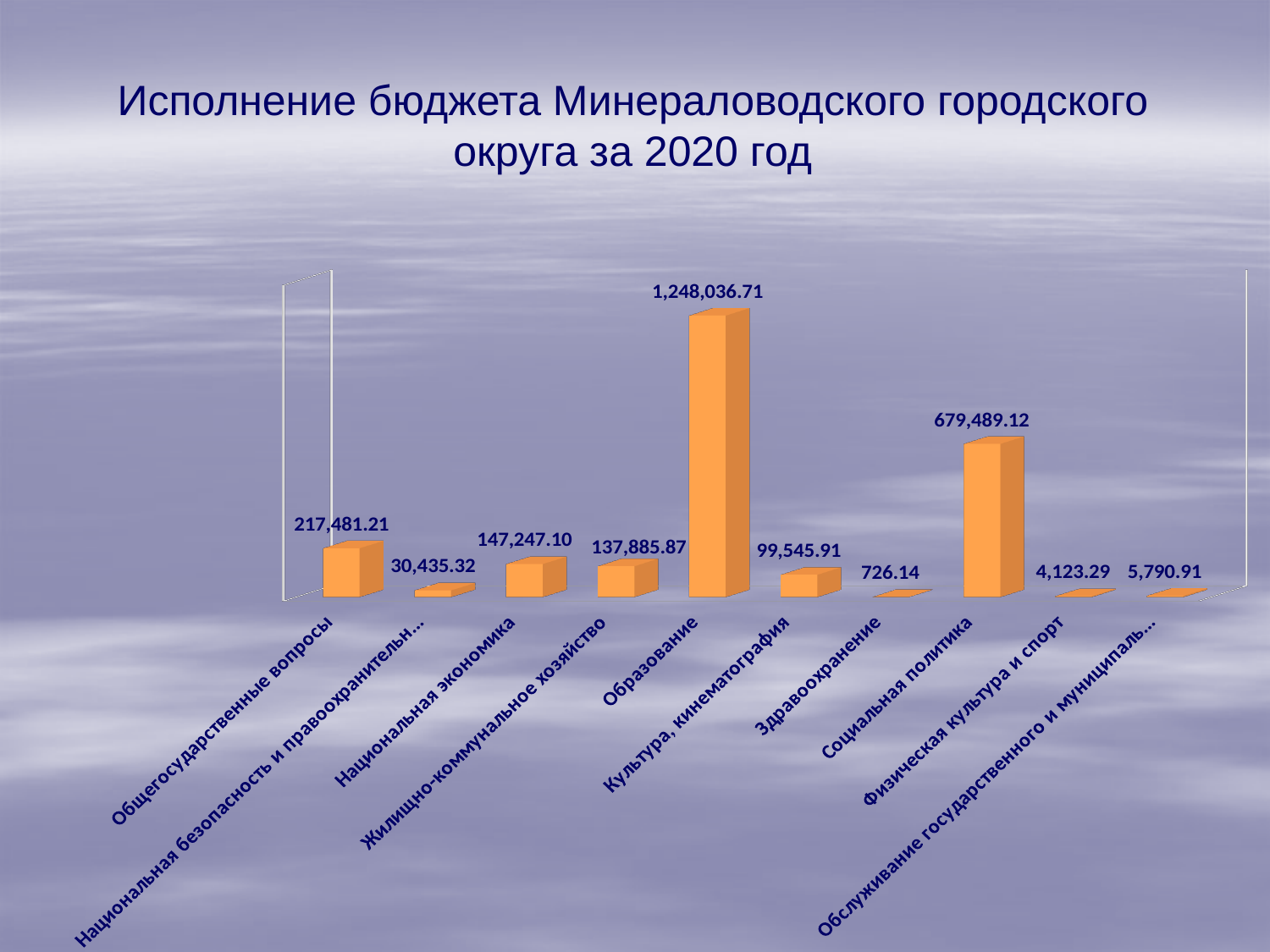
What is the value for Здравоохранение? 726.14 What is the value for Общегосударственные вопросы? 217,481.21 What type of chart is shown on the slide? Bar chart Which is larger, the value for Физическая культура и спорт or the value for Здравоохранение? Физическая культура и спорт What is the difference between the values for Национальная экономика and Жилищно-коммунальное хозяйство? 9,361.23 What is the value for Образование? 1,248,036.71 What is the value for Культура, кинематография? 99,545.91 Which category has the lowest value? Здравоохранение Which category has the highest value? Образование What is the difference between the values for Образование and Социальная политика? 568,547.59 What is the value for Социальная политика? 679,489.12 How many categories are shown in the chart? 10